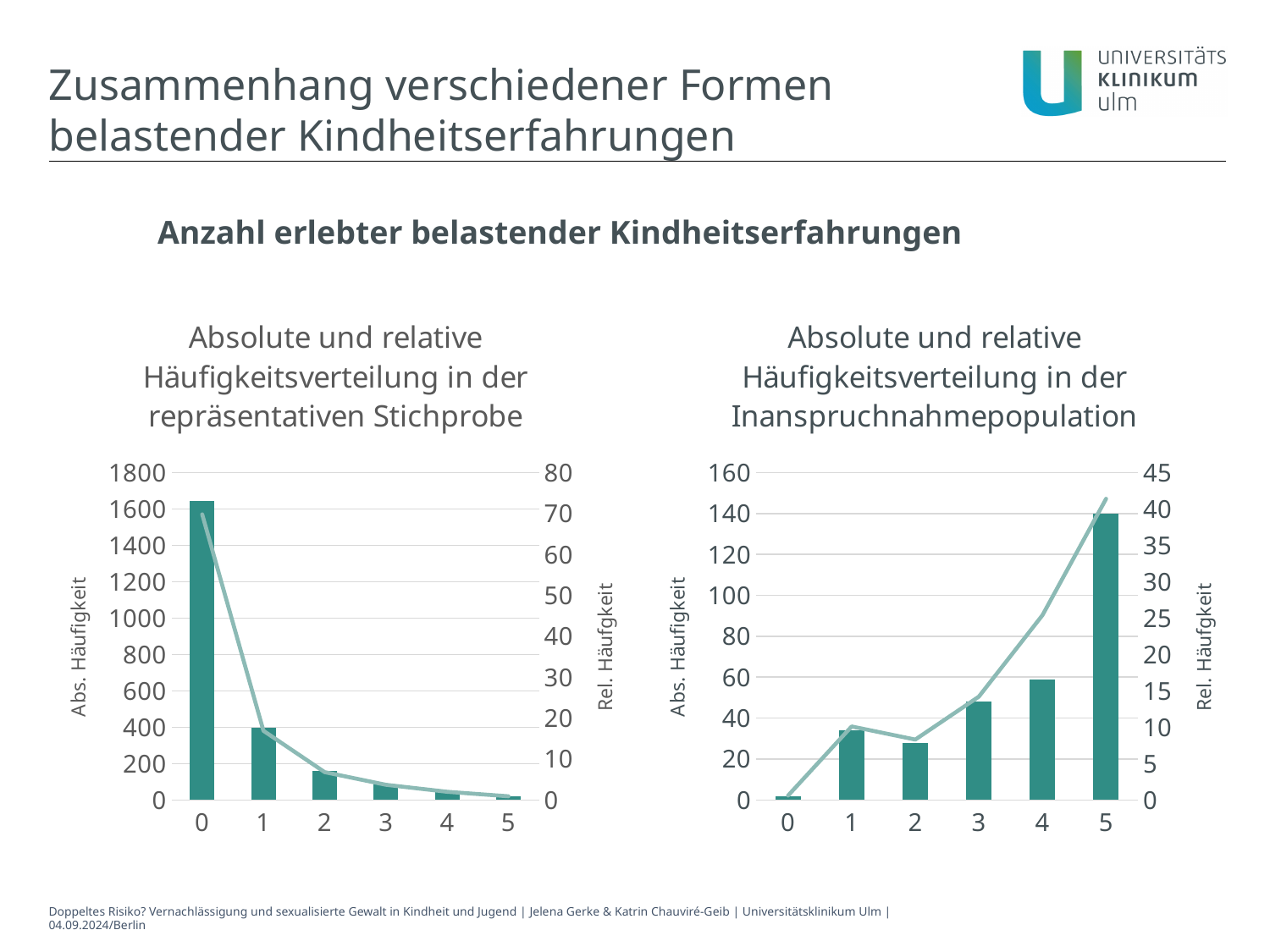
What is the label of the right-hand vertical axis in the left chart (repräsentative Stichprobe)? Rel. Häufigkeit In the right chart (Inanspruchnahmepopulation), which category on the x axis has the lowest bar? 0 In the left chart (repräsentative Stichprobe), is the absolute frequency bar for category 0 greater or less than 1400? greater In the left chart (repräsentative Stichprobe), is the absolute frequency bar for category 1 greater or less than 600? less In the right chart (Inanspruchnahmepopulation), which bar is taller, category 1 or category 2? 1 In the right chart (Inanspruchnahmepopulation), is the absolute frequency bar for category 5 greater or less than 120? greater In the left chart (repräsentative Stichprobe), do the bar values rise or fall as you move from 0 to 5 along the x axis? fall In the right chart (Inanspruchnahmepopulation), which category on the x axis has the highest bar? 5 How many categories are shown on the x axis of the right chart (Inanspruchnahmepopulation)? 6 In the left chart (repräsentative Stichprobe), which category on the x axis has the highest bar? 0 In the left chart (repräsentative Stichprobe), which category on the x axis has the lowest bar? 5